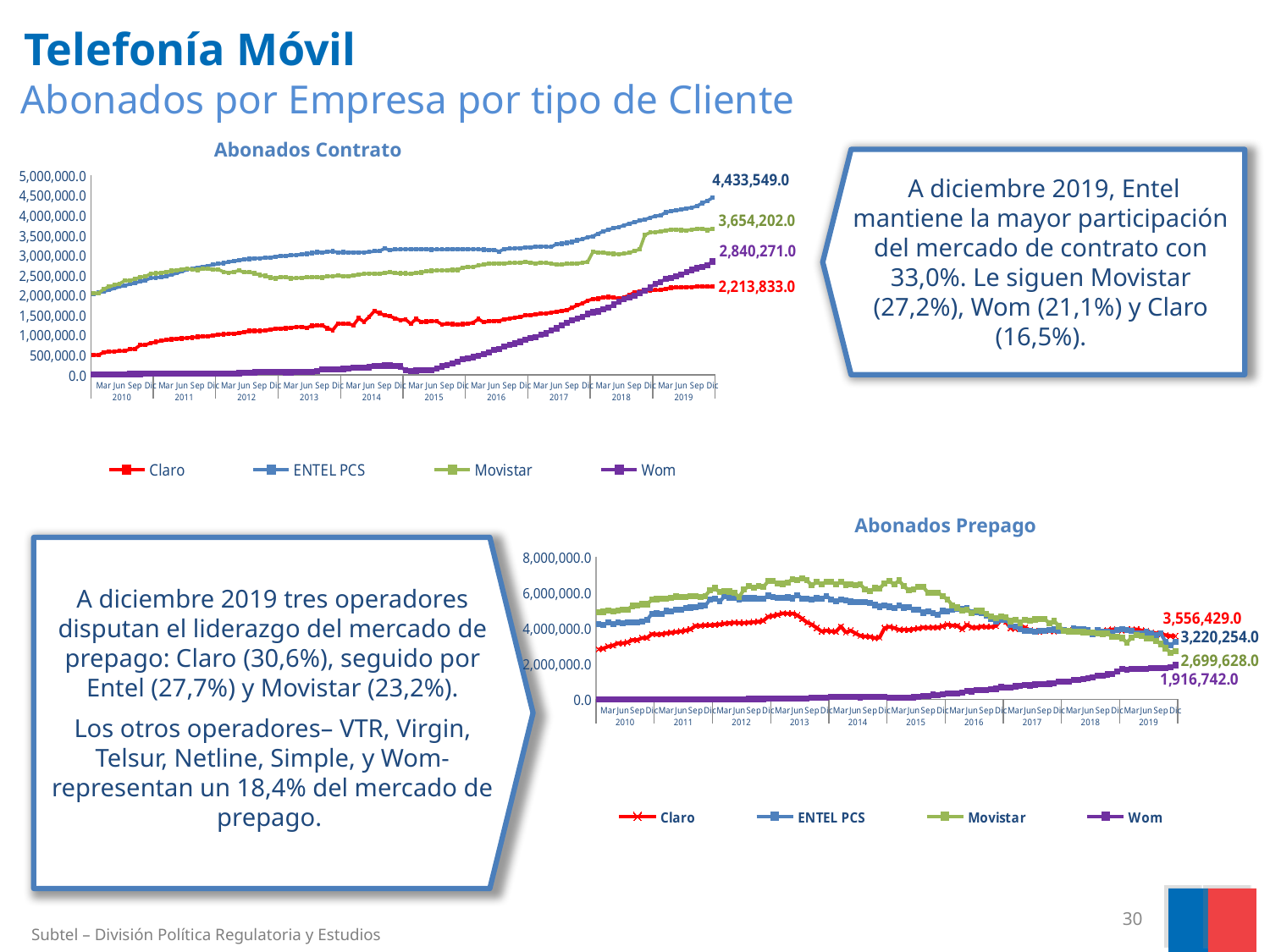
In the Abonados Prepago chart, what is the final labelled value for Movistar? 2,699,628.0 In the Abonados Prepago chart, which has the larger final labelled value, Claro or ENTEL PCS? Claro In the Abonados Contrato chart, what is the final labelled value for ENTEL PCS? 4,433,549.0 In the Abonados Contrato chart, is the value for Claro at the start of 2010 greater or less than 1,000,000.0? less In the Abonados Contrato chart, does the Wom series rise or fall from 2015 to 2019? Rise In the Abonados Prepago chart, which series has the lowest final labelled value? Wom What kind of chart is the Abonados Contrato chart? Line chart In the Abonados Contrato chart, what is the final labelled value for Wom? 2,840,271.0 In the Abonados Contrato chart, which series has the highest final labelled value? ENTEL PCS In the Abonados Contrato chart, what is the difference between the final labelled values of ENTEL PCS and Movistar? 779,347.0 In the Abonados Prepago chart, what is the final labelled value for Claro? 3,556,429.0 How many series does the legend of the Abonados Prepago chart list? 4